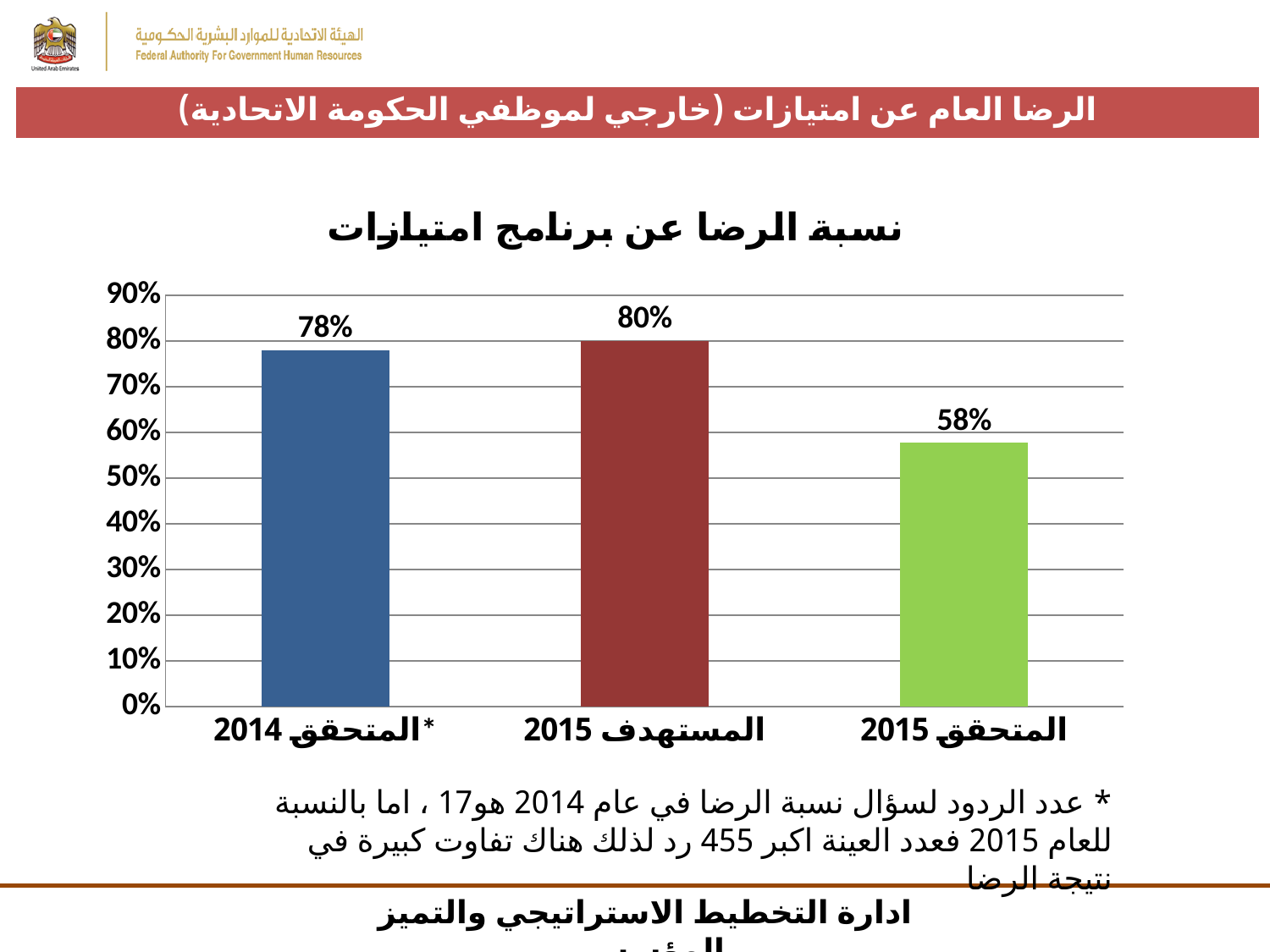
Is the value for المتحقق 2015 greater or less than 60%? less Which category has the highest value in the chart? المستهدف 2015 What is the value for المتحقق 2014* in the chart? 78% What is the title of the chart? نسبة الرضا عن برنامج امتيازات What is the difference between the values for المستهدف 2015 and المتحقق 2015? 22% Which is larger, the value for المتحقق 2014* or the value for المتحقق 2015? المتحقق 2014* What is the value for المستهدف 2015 in the chart? 80% What is the value for المتحقق 2015 in the chart? 58% What kind of chart is shown on the slide? bar chart How many categories are shown in the chart? 3 Which category has the lowest value in the chart? المتحقق 2015 What is the difference between the values for المستهدف 2015 and المتحقق 2014*? 2%